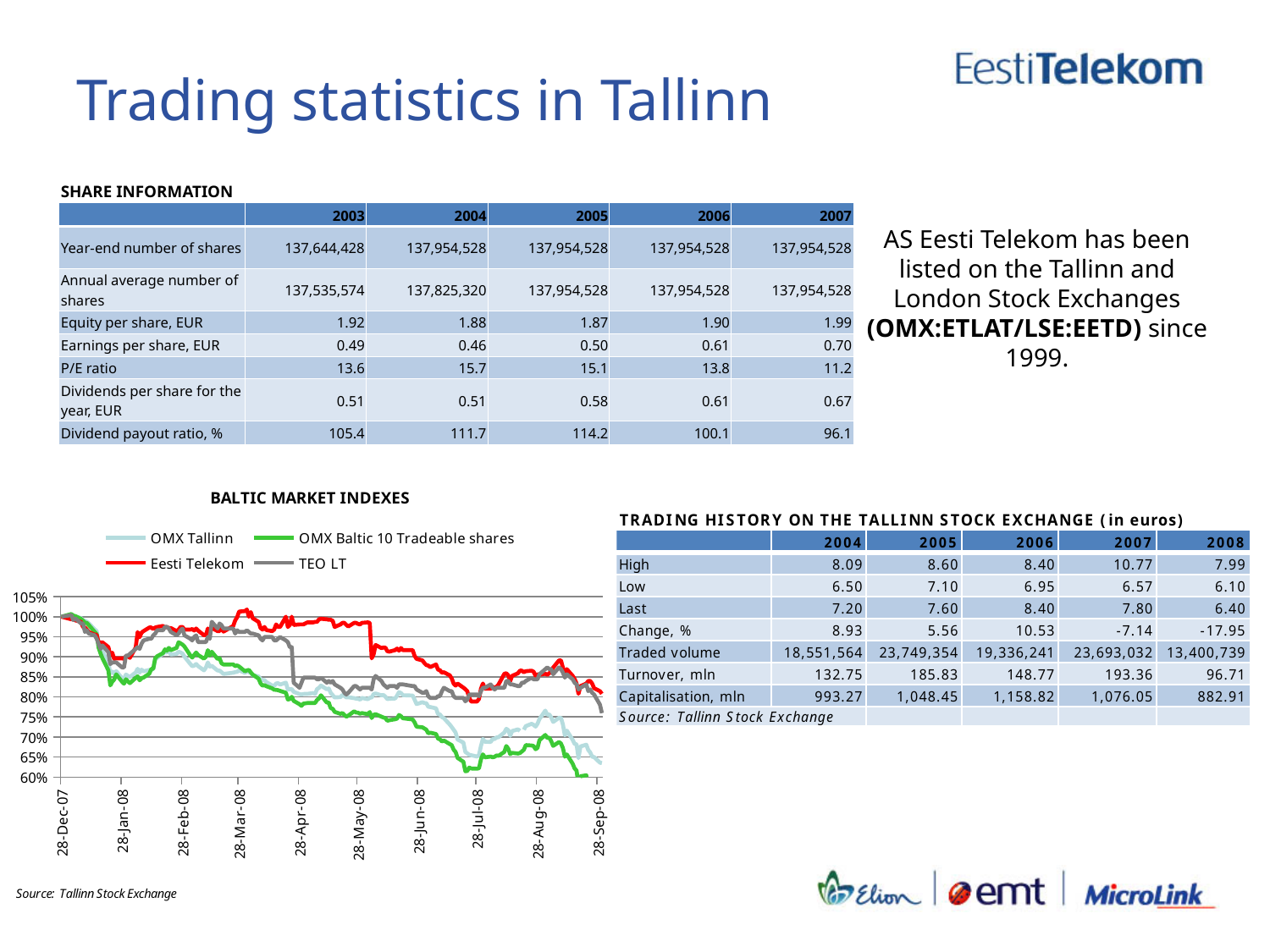
In the BALTIC MARKET INDEXES chart, is the value for OMX Tallinn at 28-Sep-08 greater or less than 60%? greater In the BALTIC MARKET INDEXES chart, which series is drawn in red? Eesti Telekom In the BALTIC MARKET INDEXES chart, do the series generally rise or fall from 28-Dec-07 to 28-Sep-08? fall In the BALTIC MARKET INDEXES chart, is the value for OMX Baltic 10 Tradeable shares at 28-Sep-08 greater or less than 65%? less In the BALTIC MARKET INDEXES chart, which series is lowest at 28-Sep-08? OMX Baltic 10 Tradeable shares In the BALTIC MARKET INDEXES chart, is the value for Eesti Telekom at 28-Sep-08 greater or less than 75%? greater How many date labels are shown on the x axis of the BALTIC MARKET INDEXES chart? 10 In the BALTIC MARKET INDEXES chart, what value do all series start at on 28-Dec-07? 100% How many series does the legend of the BALTIC MARKET INDEXES chart list? 4 In the BALTIC MARKET INDEXES chart, which is higher at 28-Sep-08: Eesti Telekom or OMX Baltic 10 Tradeable shares? Eesti Telekom What kind of chart is the BALTIC MARKET INDEXES chart? line chart